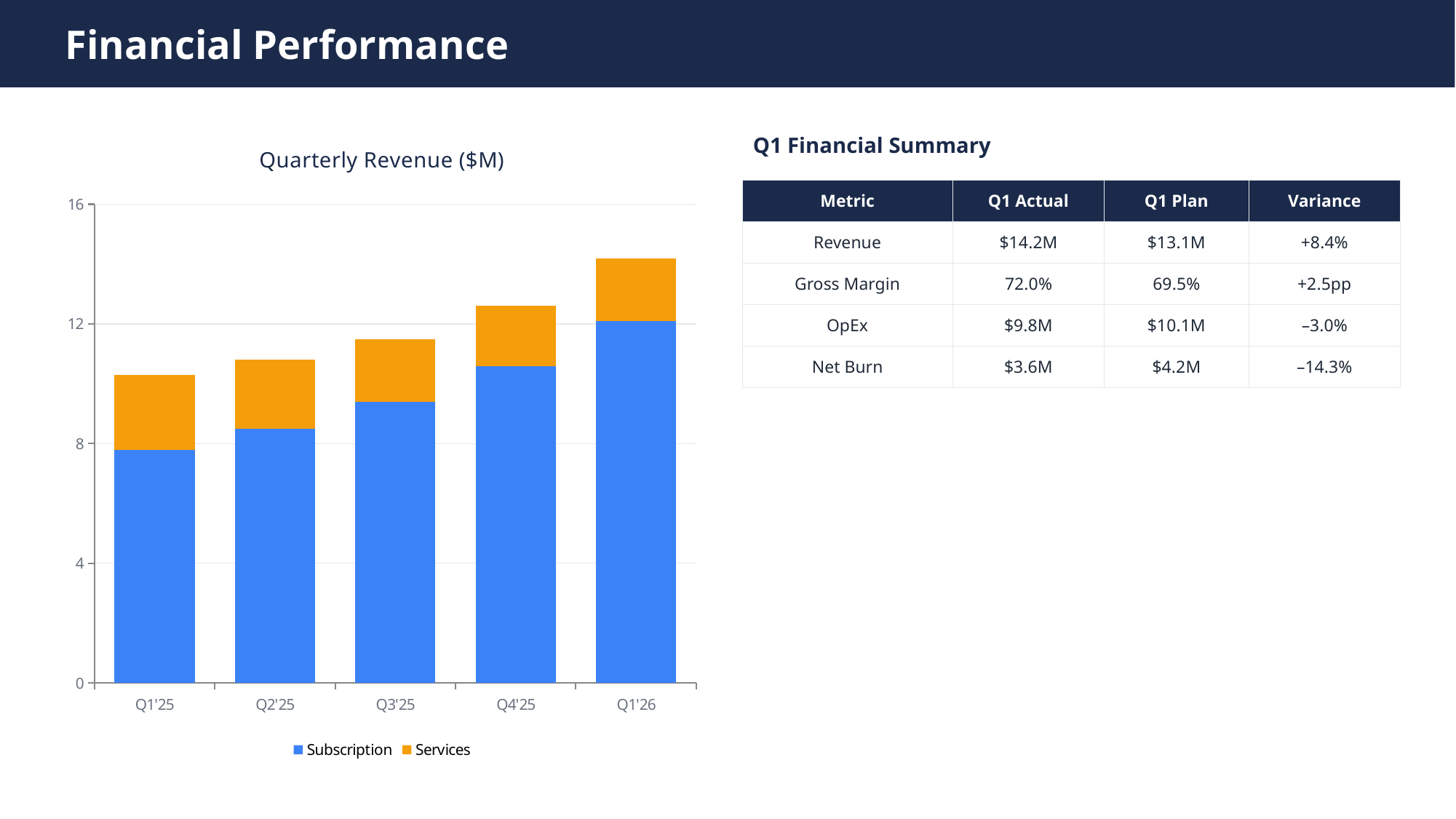
Is the total revenue bar for Q3'25 greater or less than 12? less Which quarter has the highest total revenue bar? Q1'26 Is the total revenue bar for Q1'26 greater or less than 12? greater Which quarter has a taller total revenue bar, Q2'25 or Q4'25? Q4'25 What is the title of the chart? Quarterly Revenue ($M) How many quarters are shown on the x axis of the chart? 5 Is the Subscription value for Q4'25 greater or less than 8? greater What kind of chart is shown on the slide? bar chart Which colour represents the Services series in the chart? orange Which quarter has the lowest total revenue bar? Q1'25 How many series does the chart legend list? 2 Do the total revenue bars rise or fall from Q1'25 to Q1'26? rise